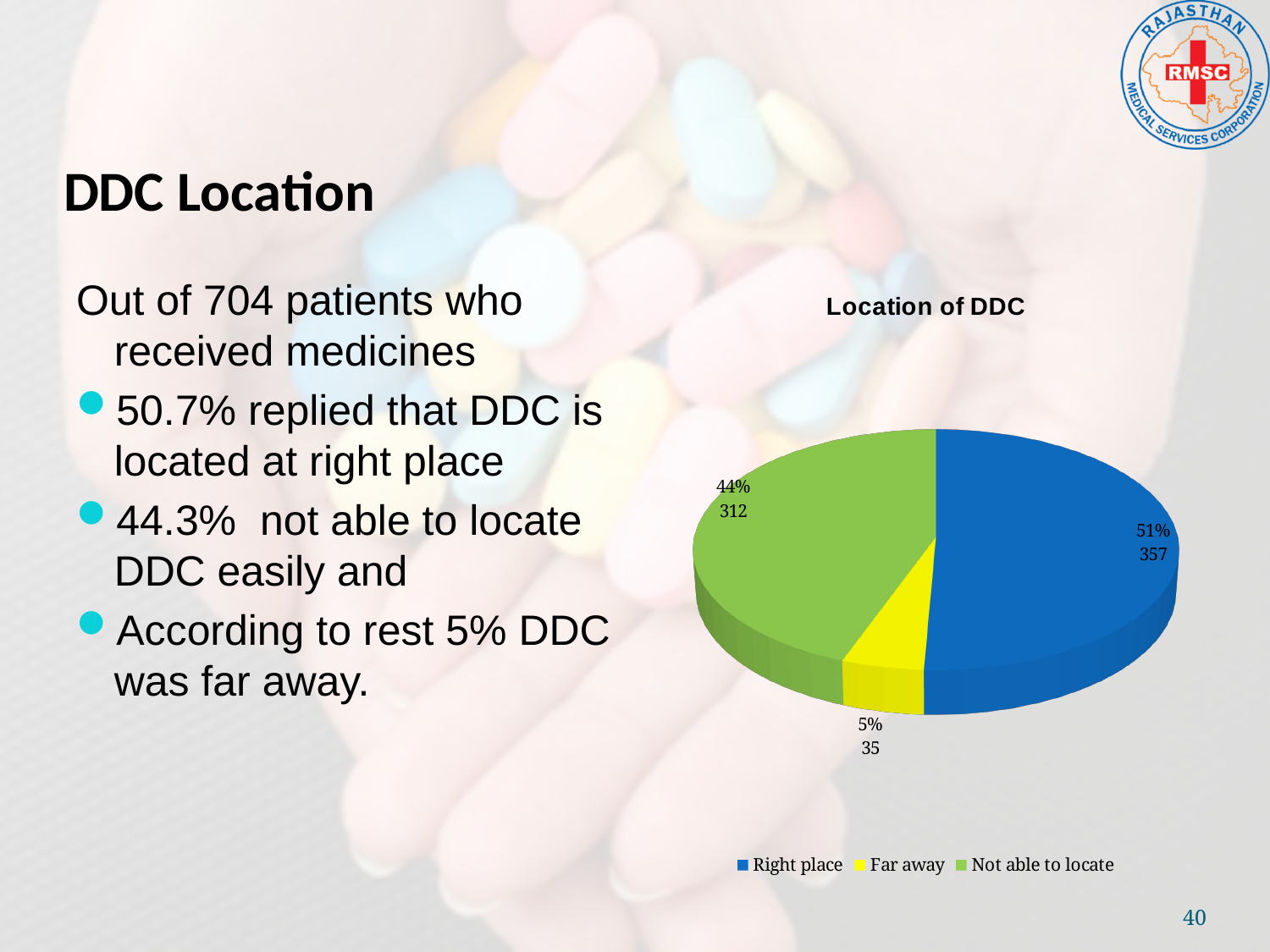
What is the difference between the values for Right place and Not able to locate? 45 How many entries does the legend list? 3 What is the value for Not able to locate? 312 What kind of chart is shown on the slide? Pie chart What share of the pie does Far away represent? 5% Which category has the largest slice? Right place What is the value for Far away? 35 Which category has the smallest slice? Far away What share of the pie does Right place represent? 51% How many slices does the pie chart have? 3 What is the title of the chart? Location of DDC What is the value for Right place? 357